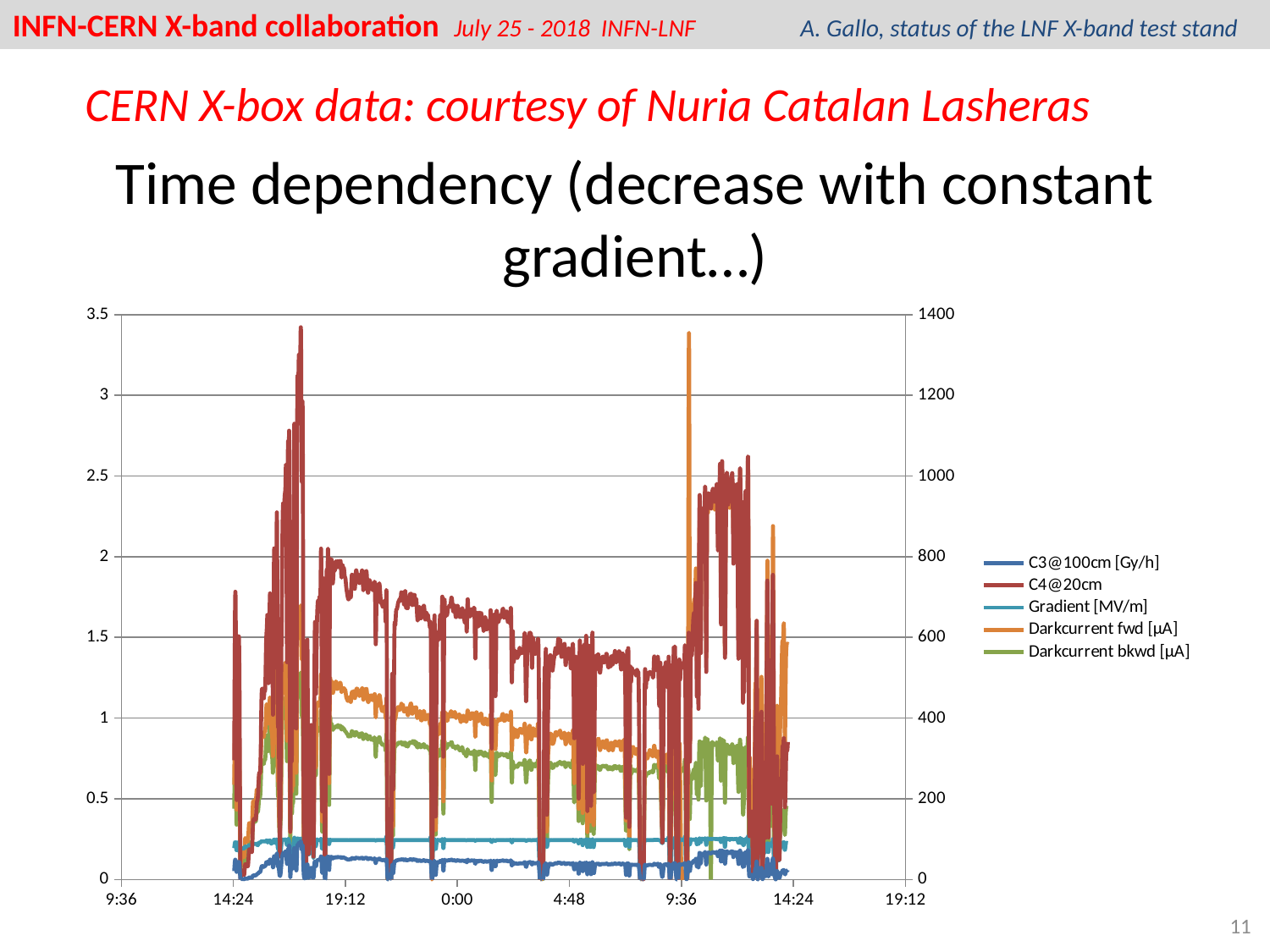
What kind of chart is shown on the slide? line chart What is the highest tick value shown on the left vertical axis? 3.5 What are the series names listed in the legend? C3@100cm [Gy/h], C4@20cm, Gradient [MV/m], Darkcurrent fwd [µA], Darkcurrent bkwd [µA] Does the Gradient [MV/m] series rise, fall, or stay roughly constant between 19:12 and 9:36? stay roughly constant Does the Darkcurrent bkwd [µA] series rise or fall between the 19:12 and 4:48 x-axis labels? fall How many series does the legend list? 5 How many time labels are shown along the x axis? 8 Does the Darkcurrent fwd [µA] series rise or fall between the 19:12 and 9:36 x-axis labels? fall